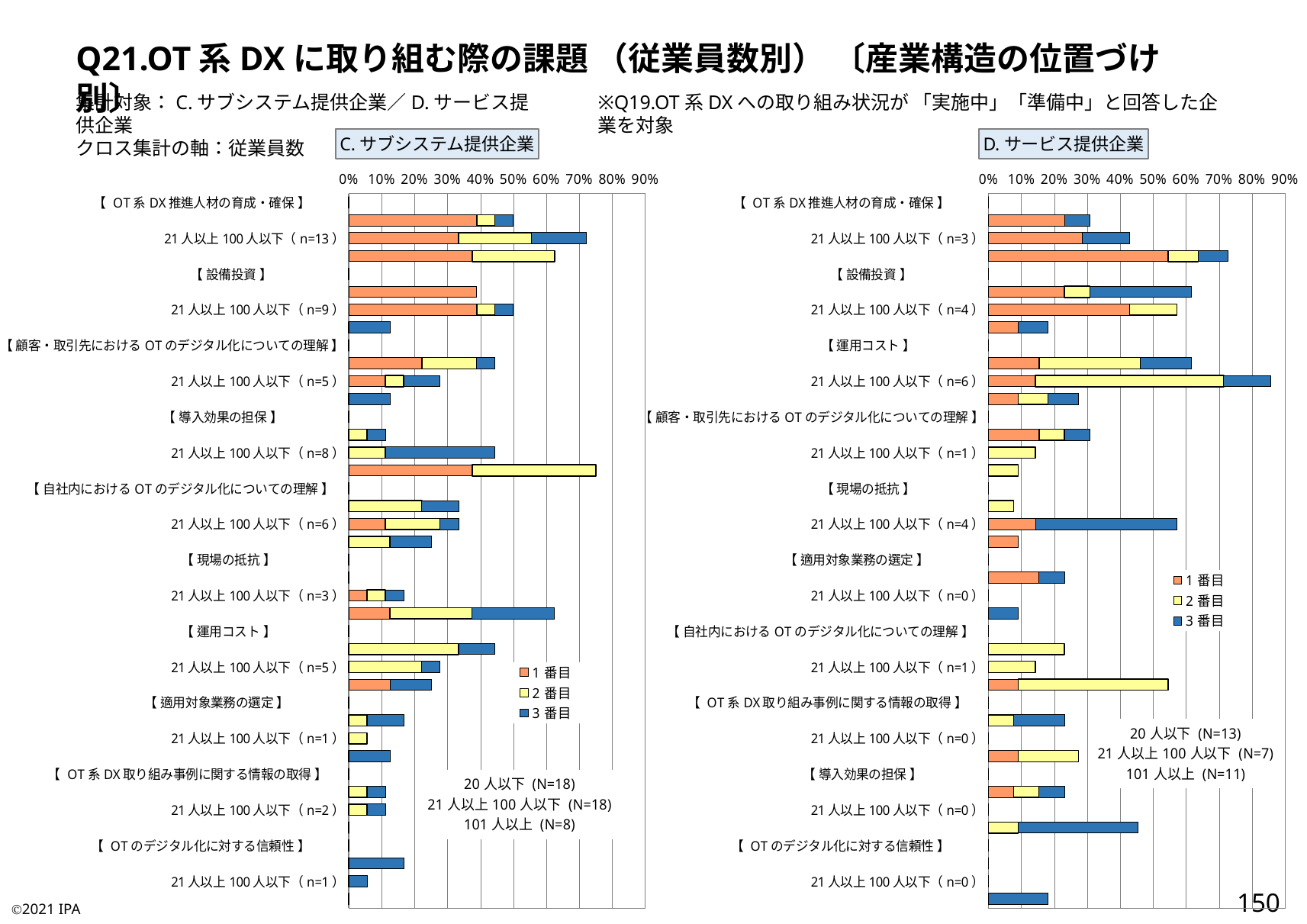
In the D. サービス提供企業 chart, is the total bar length for 21人以上100人以下 (n=6) under 【運用コスト】 greater or less than 80%? greater In the C. サブシステム提供企業 chart, what is the N value given for 101人以上? N=8 In the D. サービス提供企業 chart, what is the N value given for 20人以下? N=13 In the C. サブシステム提供企業 chart, how many challenge categories (the bracketed headings) are listed? 10 In the C. サブシステム提供企業 chart, which is larger under 【OT系DX推進人材の育成・確保】: the total bar for 21人以上100人以下 (n=13) or the bar directly above it (20人以下)? 21人以上100人以下 (n=13) What kind of chart is used for C. サブシステム提供企業 on the left of the slide? Stacked bar chart What is the highest percentage tick shown on the x axis of the D. サービス提供企業 chart? 90% In the C. サブシステム提供企業 chart, is the total bar length for 21人以上100人以下 (n=1) under 【適用対象業務の選定】 greater or less than 10%? less What are the three legend entries shown for the C. サブシステム提供企業 chart? 1番目, 2番目, 3番目 In the C. サブシステム提供企業 chart, is the total bar length for 21人以上100人以下 (n=13) under 【OT系DX推進人材の育成・確保】 greater or less than 60%? greater How many series does the legend of the D. サービス提供企業 chart list? 3